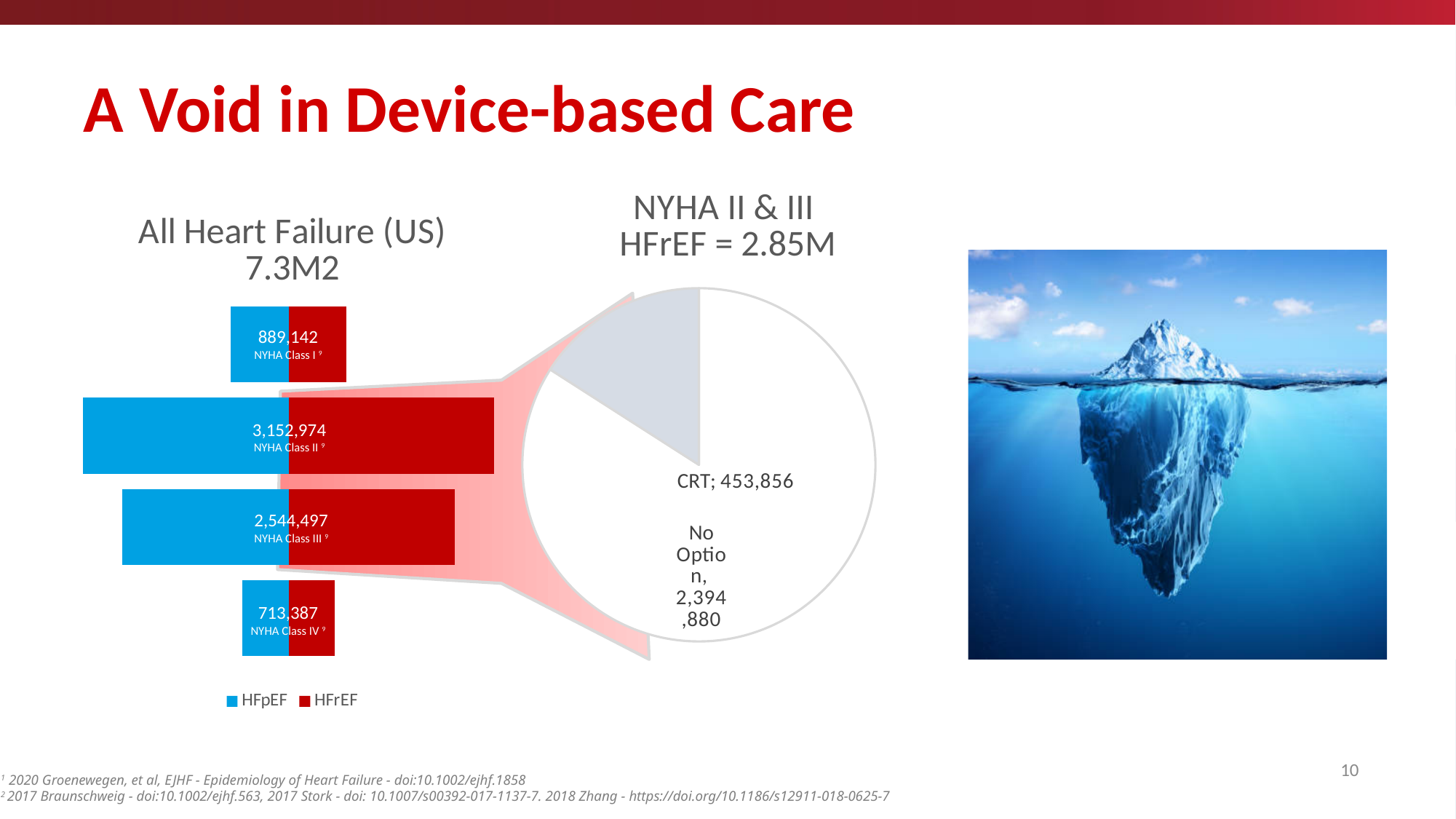
In the 'NYHA II & III HFrEF = 2.85M' pie chart, what is the difference between the No Option and CRT values? 1,941,024 In the 'All Heart Failure (US)' chart, which NYHA class has the lowest labelled value? NYHA Class IV In the 'All Heart Failure (US)' chart, what value is labelled for NYHA Class II? 3,152,974 In the 'NYHA II & III HFrEF = 2.85M' pie chart, what is the value for CRT? 453,856 In the 'All Heart Failure (US)' chart, which is larger, the value for NYHA Class I or NYHA Class IV? NYHA Class I In the 'All Heart Failure (US)' chart, which NYHA class has the highest labelled value? NYHA Class II How many series does the legend of the 'All Heart Failure (US)' chart list? 2 What kind of chart is the 'All Heart Failure (US)' chart? Bar chart In the 'All Heart Failure (US)' chart, what value is labelled for NYHA Class IV? 713,387 In the 'All Heart Failure (US)' chart, what is the difference between the labelled values for NYHA Class II and NYHA Class III? 608,477 In the 'NYHA II & III HFrEF = 2.85M' pie chart, what is the value for No Option? 2,394,880 How many NYHA classes are shown in the 'All Heart Failure (US)' chart? 4